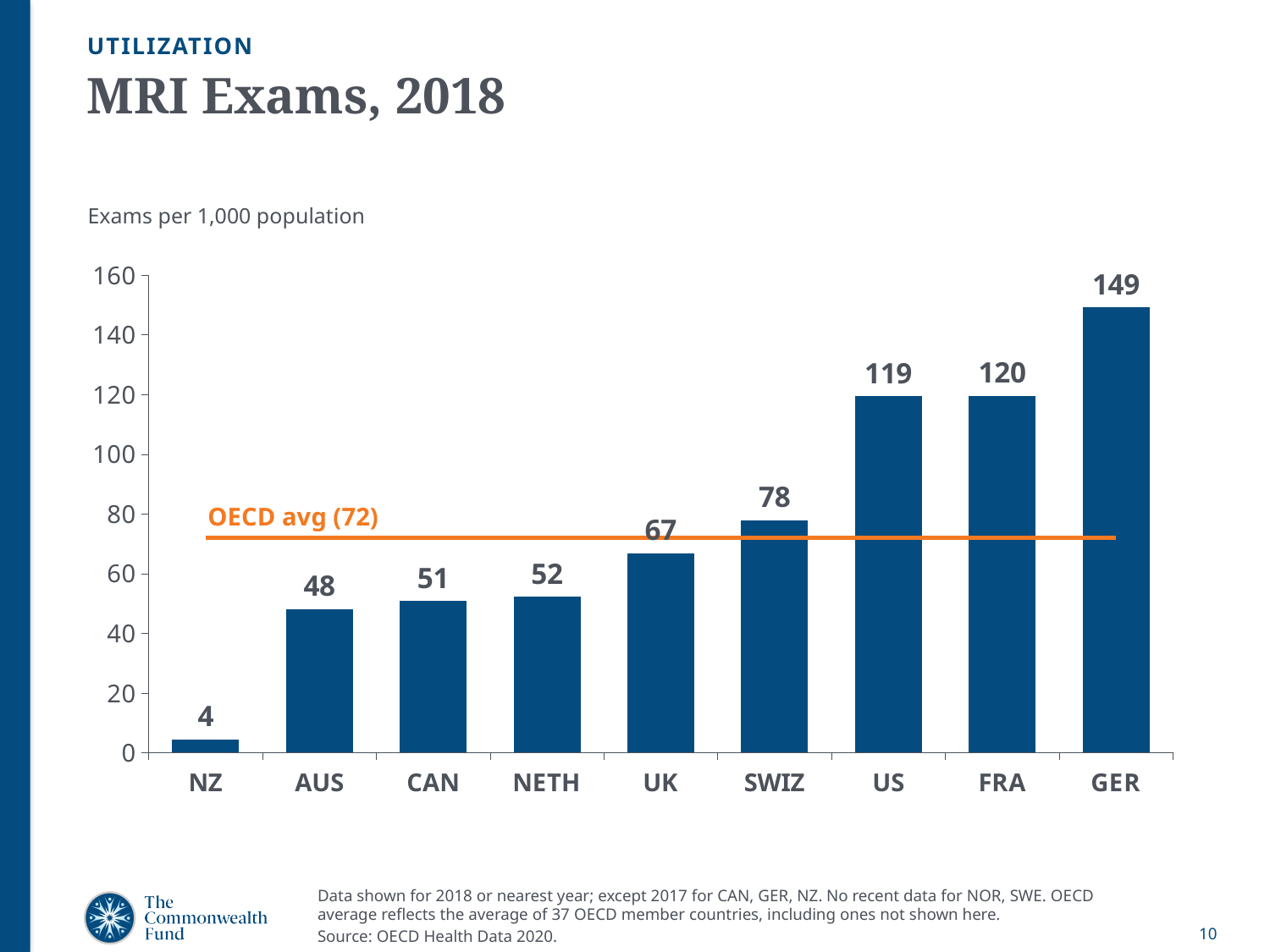
Do the values rise or fall from left to right along the x axis? rise What is the difference between the values for GER and FRA? 29 Is the value for AUS greater or less than 60? less Which country has the highest number of MRI exams per 1,000 population? GER Which is larger, the value for SWIZ or the value for UK? SWIZ What is the value for NETH? 52 How many countries are shown on the chart? 9 Which country has the lowest number of MRI exams per 1,000 population? NZ What is the value for the US? 119 What unit is the chart measured in, according to the subtitle? Exams per 1,000 population What is the OECD average shown on the chart? 72 What kind of chart is shown on the slide? bar chart